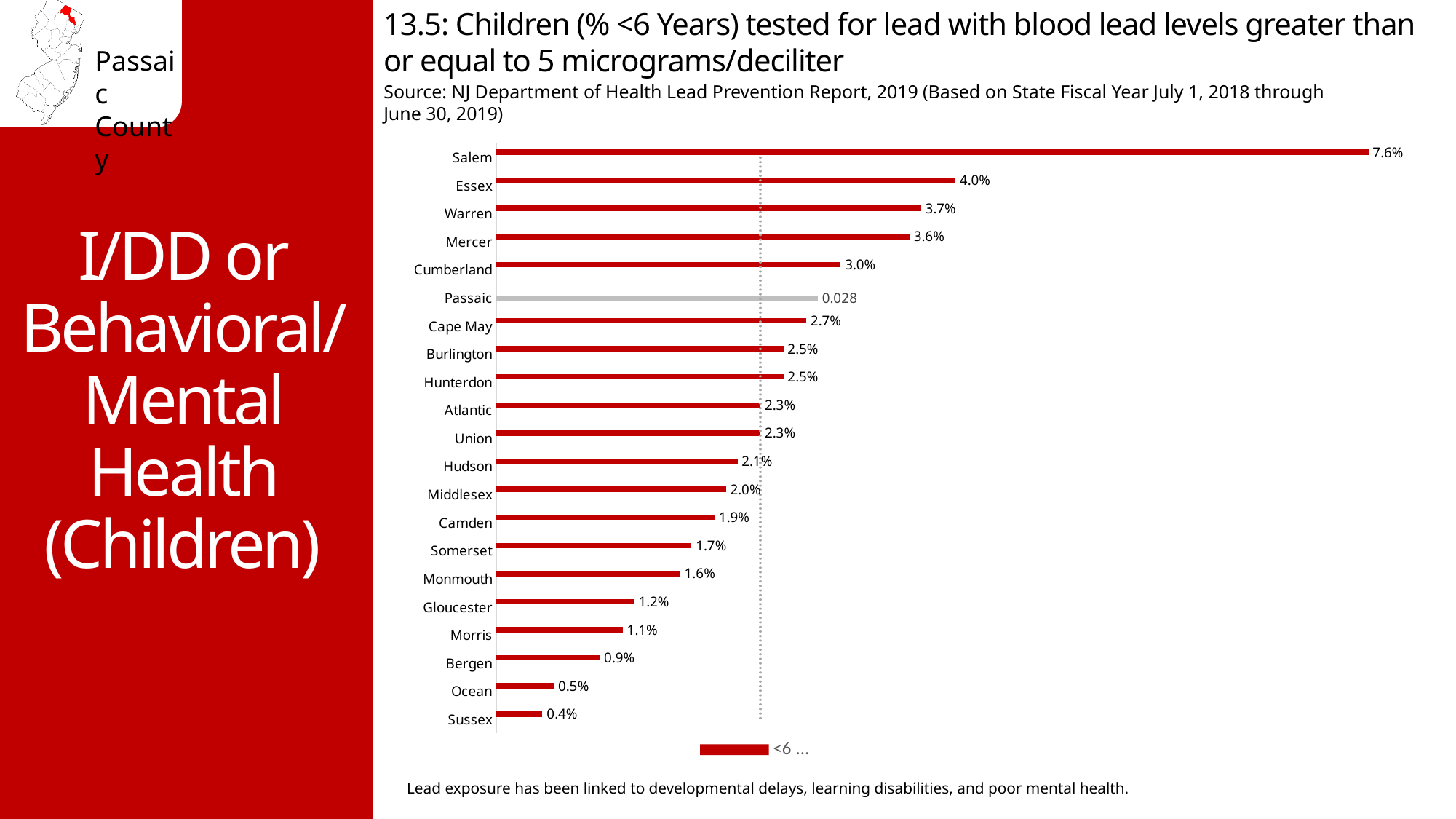
What is the value for Sussex? 0.4% Which county has the highest value? Salem How many counties are shown in the chart? 21 What is the value for Salem? 7.6% What is the value for Gloucester? 1.2% Which has a larger value, Cumberland or Cape May? Cumberland What is the value for Essex? 4.0% What value is labeled on the Passaic bar? 0.028 Which county has the lowest value? Sussex What kind of chart is shown on the slide? Bar chart What is the difference between the values for Salem and Essex? 3.6 percentage points Which county's bar is colored grey instead of red? Passaic